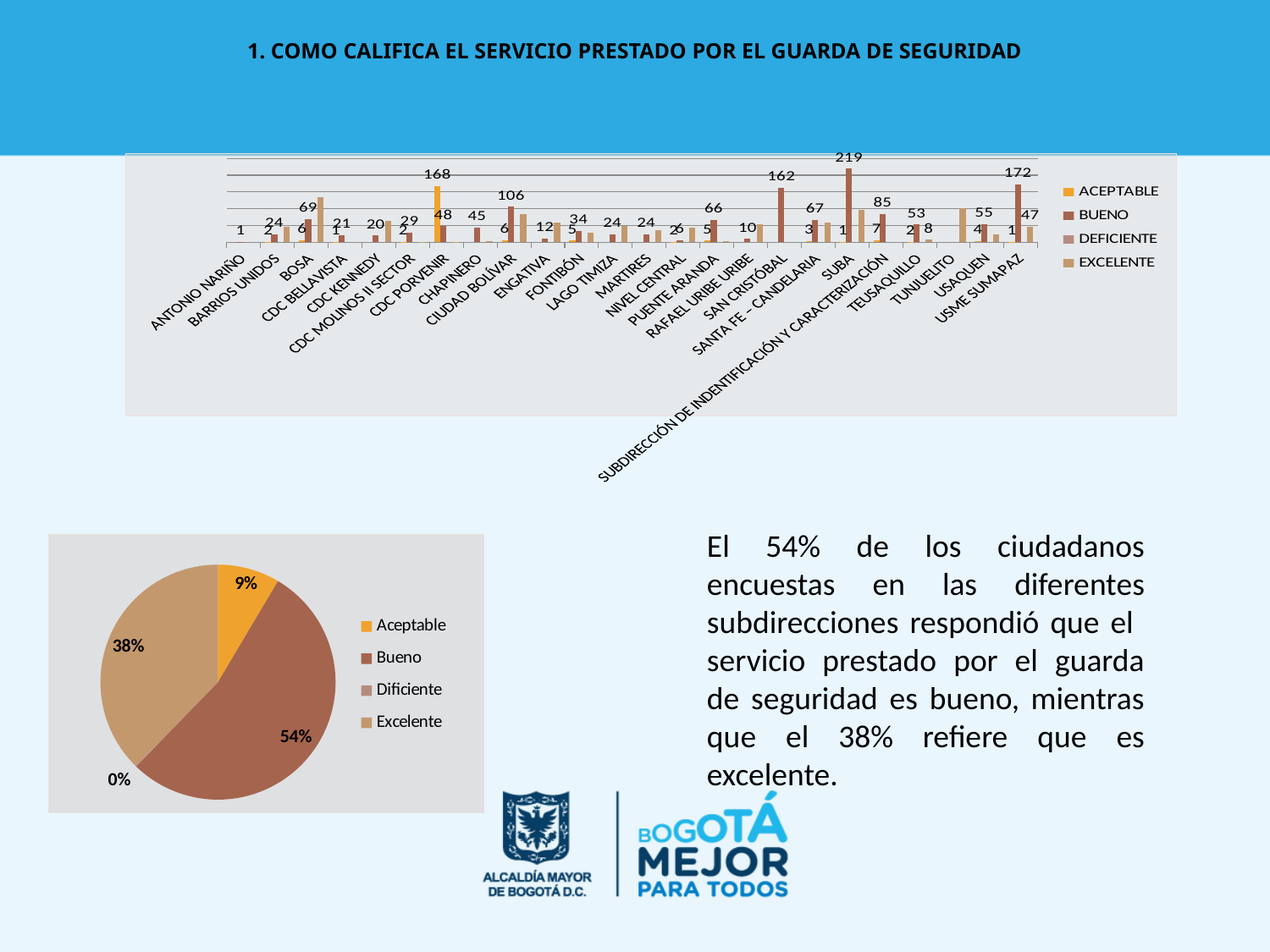
In the pie chart, how many percentage points larger is Bueno than Excelente? 16 In the pie chart, what share of respondents rated the service as Bueno? 54% In the top bar chart, which series does the tallest bar for SUBA belong to? BUENO In the pie chart, how many categories does the legend list? 4 In the top bar chart, which category has the tallest bar? SUBA What type of chart is the top chart on the slide? Bar chart In the pie chart, which category has the smallest share? Dificiente In the top bar chart, what is the highest value shown? 219 In the top bar chart, how many series does the legend list? 4 In the pie chart, what percentage corresponds to Excelente? 38% In the pie chart, what percentage corresponds to Aceptable? 9% In the pie chart, which category has the largest slice? Bueno